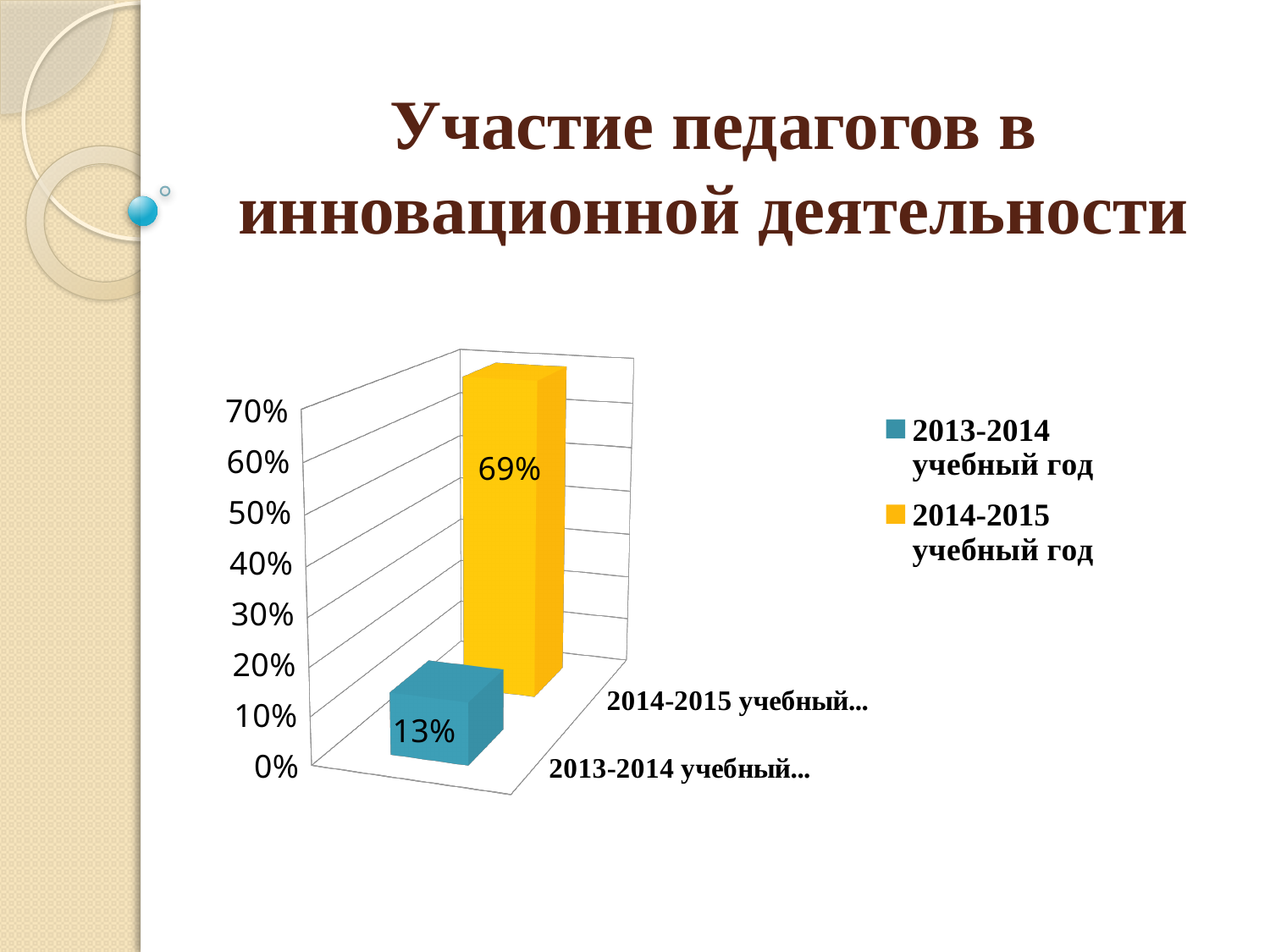
Which is larger: the value for 2013-2014 учебный год or for 2014-2015 учебный год? 2014-2015 учебный год How many bars are plotted on the chart? 2 What kind of chart is shown on the slide? bar chart What is the value for 2014-2015 учебный год? 69% What colour is the bar for 2014-2015 учебный год? yellow What is the difference between the values for 2014-2015 учебный год and 2013-2014 учебный год? 56% Which academic year has the lowest value? 2013-2014 учебный год Is the value for 2013-2014 учебный год greater or less than 20%? less Is the value for 2014-2015 учебный год greater or less than 50%? greater What is the value for 2013-2014 учебный год? 13% How many entries does the legend list? 2 Which academic year has the highest value? 2014-2015 учебный год